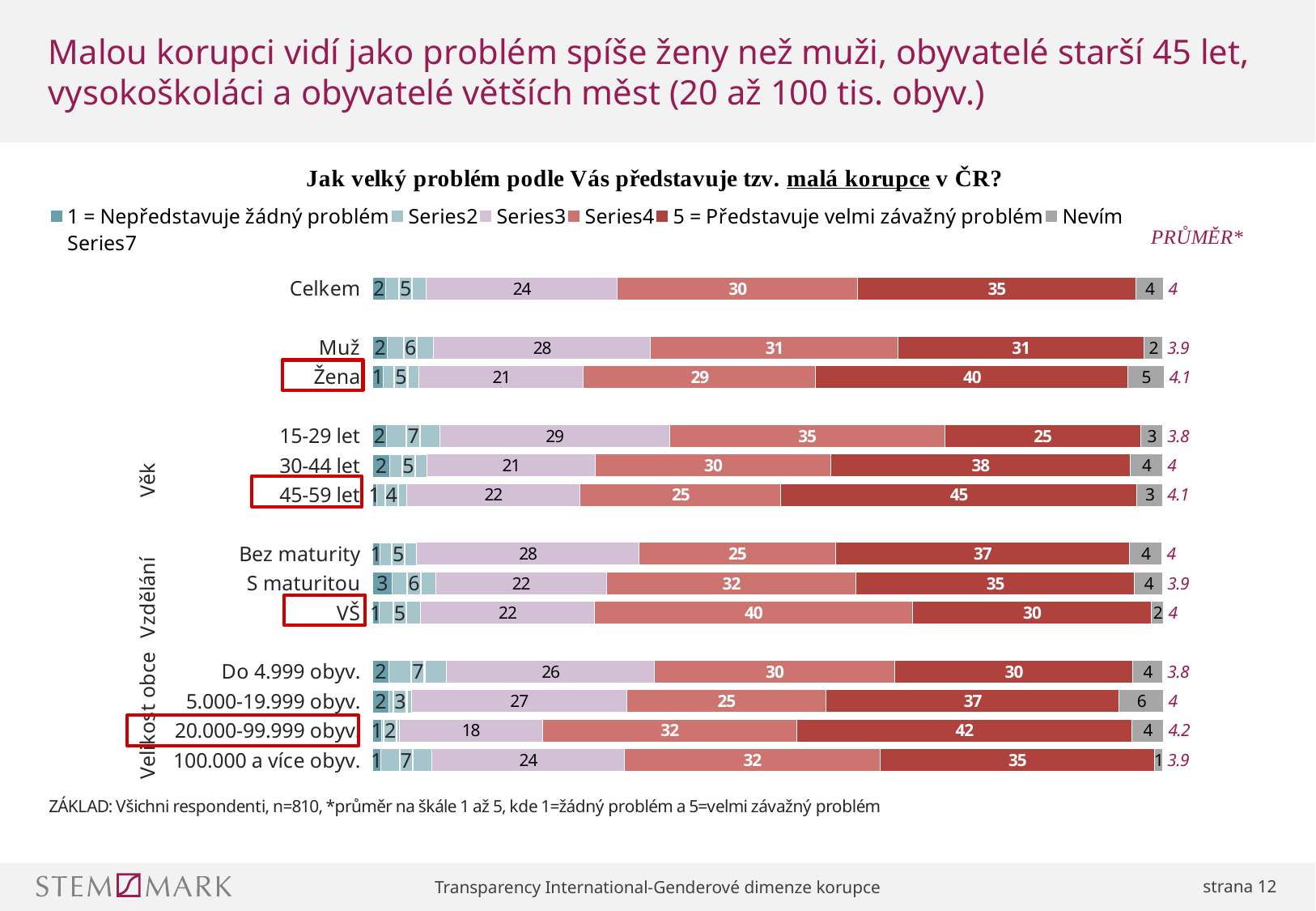
What is the difference between the '5 = Představuje velmi závažný problém' values for Žena and Muž? 9 How many series does the legend list? 7 Which category has the highest value in the '5 = Představuje velmi závažný problém' series? 45-59 let Which has a larger Series4 value, 15-29 let or 45-59 let? 15-29 let What is the value of the Series3 segment for 20.000-99.999 obyv.? 18 How many categories (rows) are plotted in the chart? 13 What is the value of the '5 = Představuje velmi závažný problém' segment for Žena? 40 Which category has the lowest value in the '5 = Představuje velmi závažný problém' series? 15-29 let What is the PRŮMĚR* value shown for 45-59 let? 4.1 What kind of chart is shown on the slide? bar chart What is the value of the Series4 segment for VŠ? 40 Which category has the highest PRŮMĚR* value? 20.000-99.999 obyv.